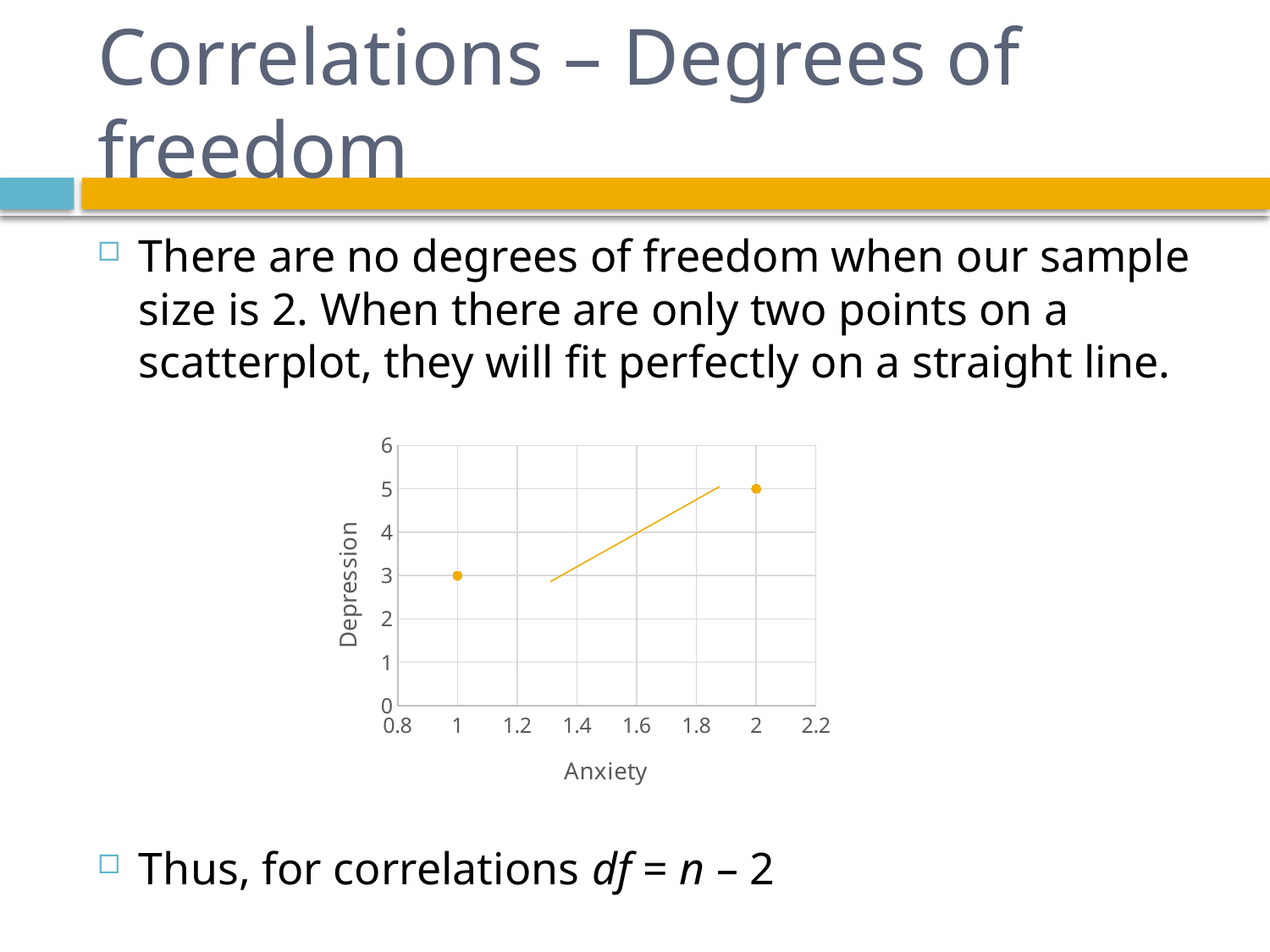
What is the Depression value for the point at Anxiety 2? 5 How many data points are plotted on the chart? 2 What kind of chart is shown on the slide? scatter plot What is the highest Depression value plotted on the chart? 5 What is the Depression value for the point at Anxiety 1? 3 Which point has the higher Depression value, the one at Anxiety 1 or the one at Anxiety 2? Anxiety 2 Is the Depression value for the point at Anxiety 2 greater or less than 4? greater What is the label of the x axis? Anxiety What is the lowest Depression value plotted on the chart? 3 Does Depression rise or fall as Anxiety increases along the x axis? rise What is the difference in Depression between the point at Anxiety 2 and the point at Anxiety 1? 2 What is the label of the y axis? Depression